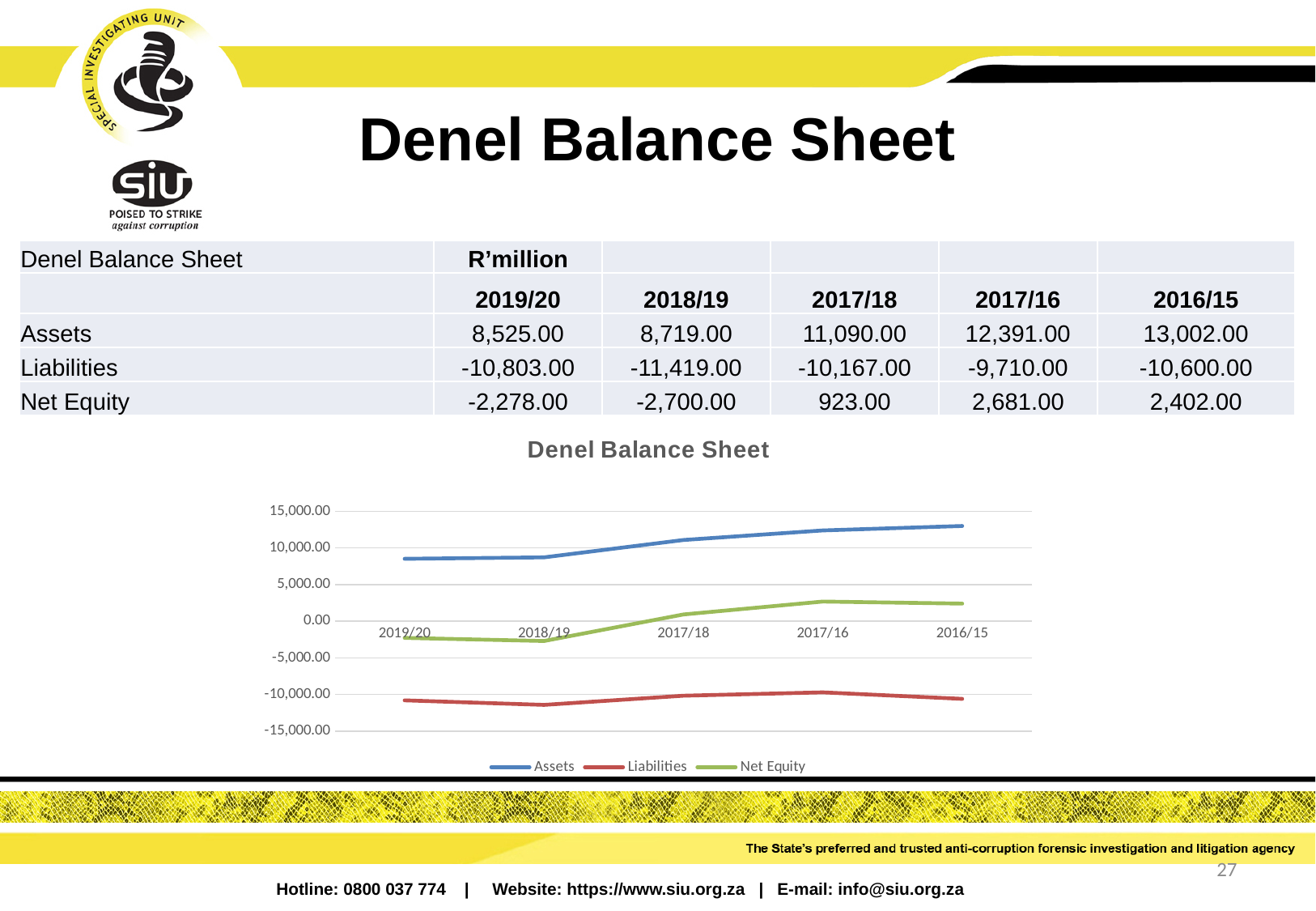
What is the value of Net Equity for 2017/18? 923.00 How many periods are shown on the x axis of the Denel Balance Sheet chart? 5 In which period is the Assets value highest? 2016/15 Is the Assets value for 2017/18 greater or less than 10,000.00? greater What is the value of Liabilities for 2018/19? -11,419.00 What kind of chart is the Denel Balance Sheet chart? line chart In which period is the Net Equity value lowest? 2018/19 Which is larger, Net Equity in 2017/16 or Net Equity in 2016/15? 2017/16 What is the difference between Assets in 2016/15 and Assets in 2019/20? 4,477.00 How many series does the legend of the Denel Balance Sheet chart list? 3 What is the value of Assets for 2019/20? 8,525.00 Which colour is used for the Liabilities line in the Denel Balance Sheet chart? red